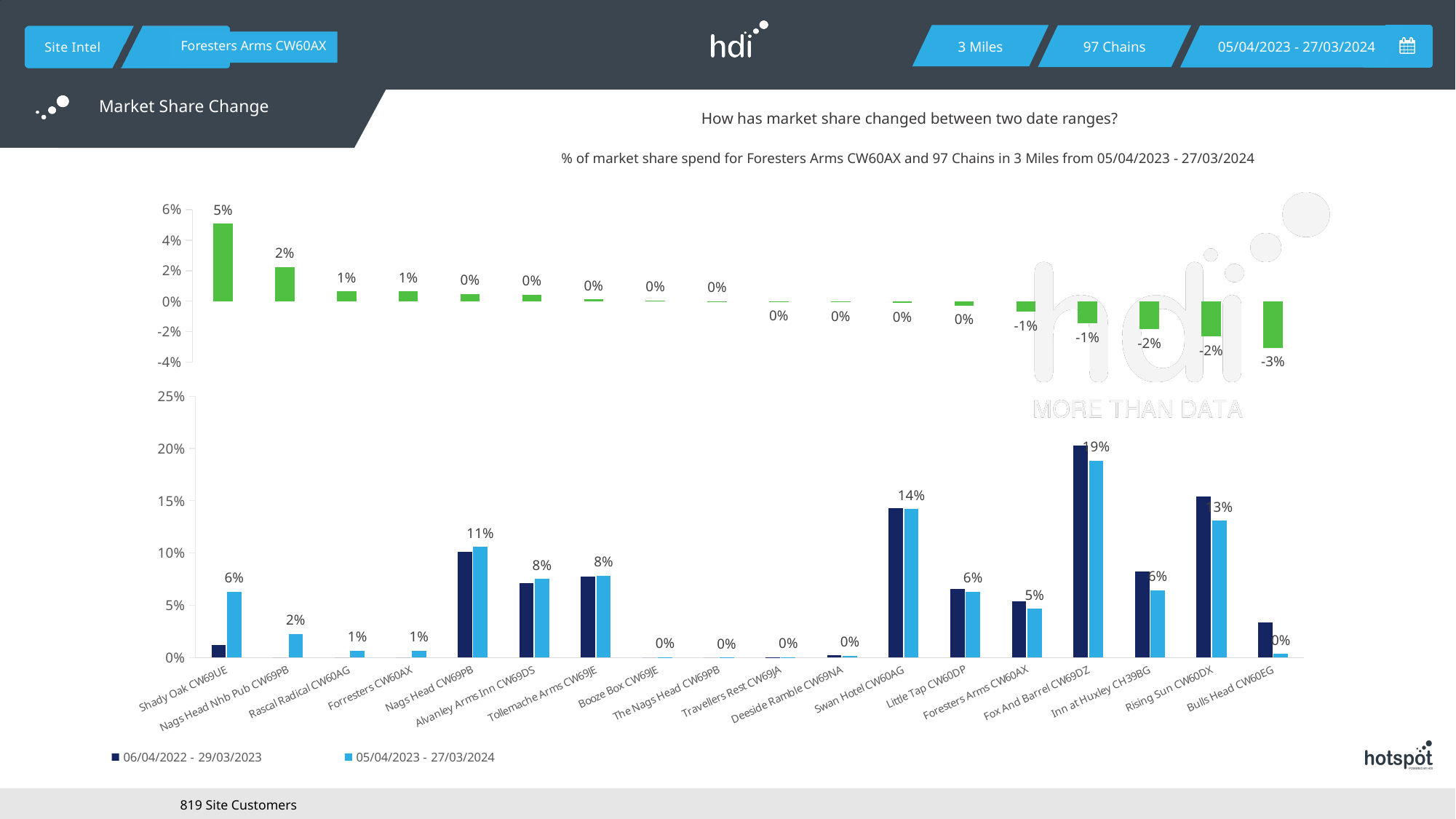
What kind of chart is the bottom chart on the slide? bar chart In the bottom chart, which is larger in the 05/04/2023 - 27/03/2024 series: Nags Head CW69PB or Alvanley Arms Inn CW69DS? Nags Head CW69PB In the bottom chart, which category has the highest value in the 05/04/2023 - 27/03/2024 series? Fox And Barrel CW69DZ In the bottom chart, is the 06/04/2022 - 29/03/2023 value for Swan Hotel CW60AG greater or less than 15%? less How many series does the legend of the bottom chart list? 2 In the bottom chart, what is the difference between the 05/04/2023 - 27/03/2024 values for Fox And Barrel CW69DZ and Swan Hotel CW60AG? 5% How many categories are shown on the x axis of the bottom chart? 18 In the bottom chart, what is the value for Fox And Barrel CW69DZ in the 05/04/2023 - 27/03/2024 series? 19% In the top chart, what is the lowest value shown? -3% In the top chart, do the values rise or fall from left to right? fall In the top chart, what is the highest value shown? 5% In the bottom chart, what is the value for Nags Head CW69PB in the 05/04/2023 - 27/03/2024 series? 11%